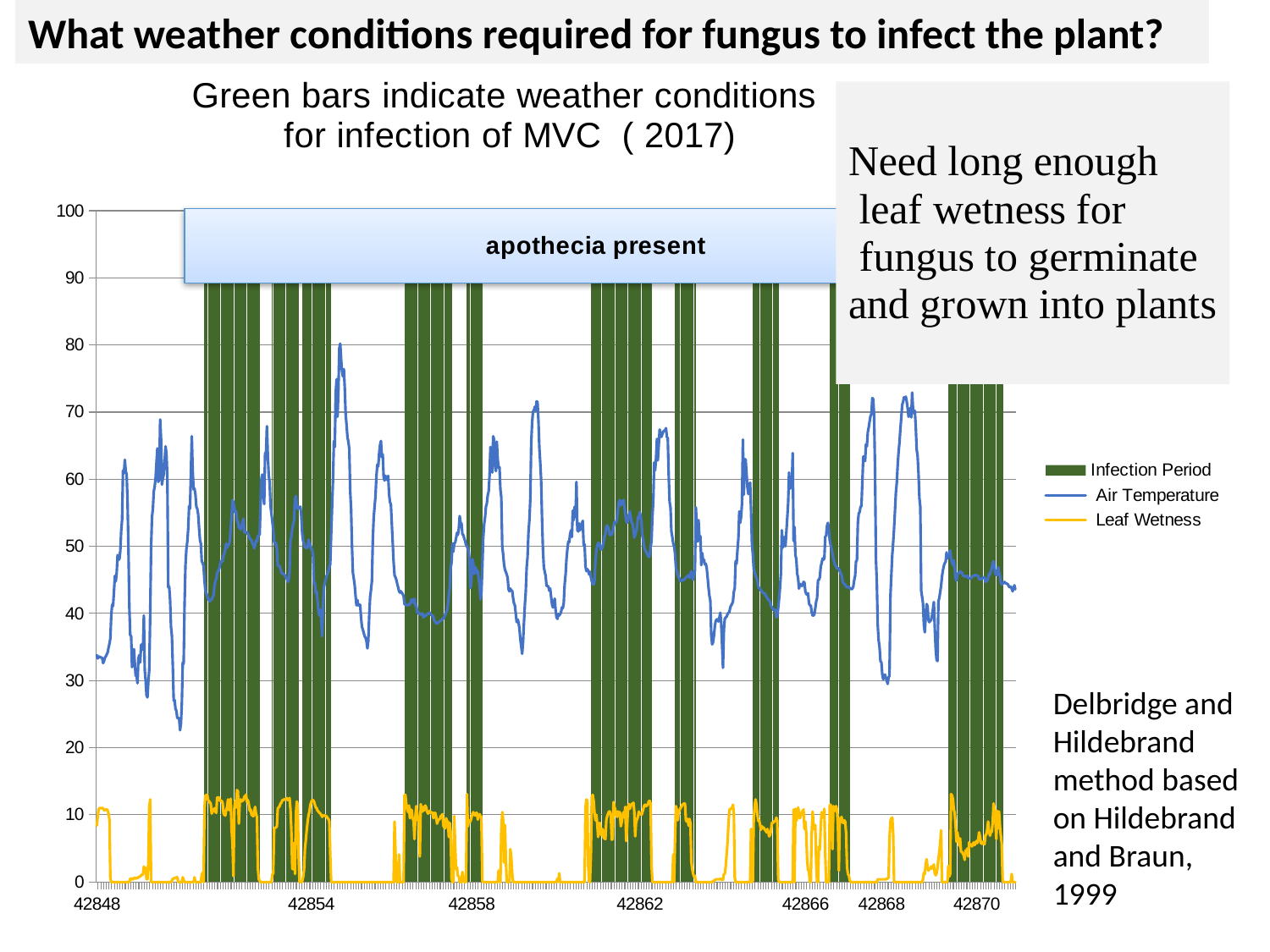
Is the lowest Air Temperature value on the chart greater or less than 30? less What is the highest value shown on the chart's vertical axis? 100 Which series is drawn as the blue line in the chart? Air Temperature What is the first label on the chart's horizontal axis? 42848 Which series is drawn as green bars in the chart? Infection Period How many labels are printed along the chart's horizontal axis? 7 Is the highest Air Temperature value on the chart greater or less than 70? greater Which series reaches higher values on the chart, Air Temperature or Leaf Wetness? Air Temperature Is the highest Leaf Wetness value on the chart greater or less than 20? less How many series does the chart legend list? 3 What is the last label on the chart's horizontal axis? 42870 What kind of chart is shown on the slide? A combination chart of bars and lines